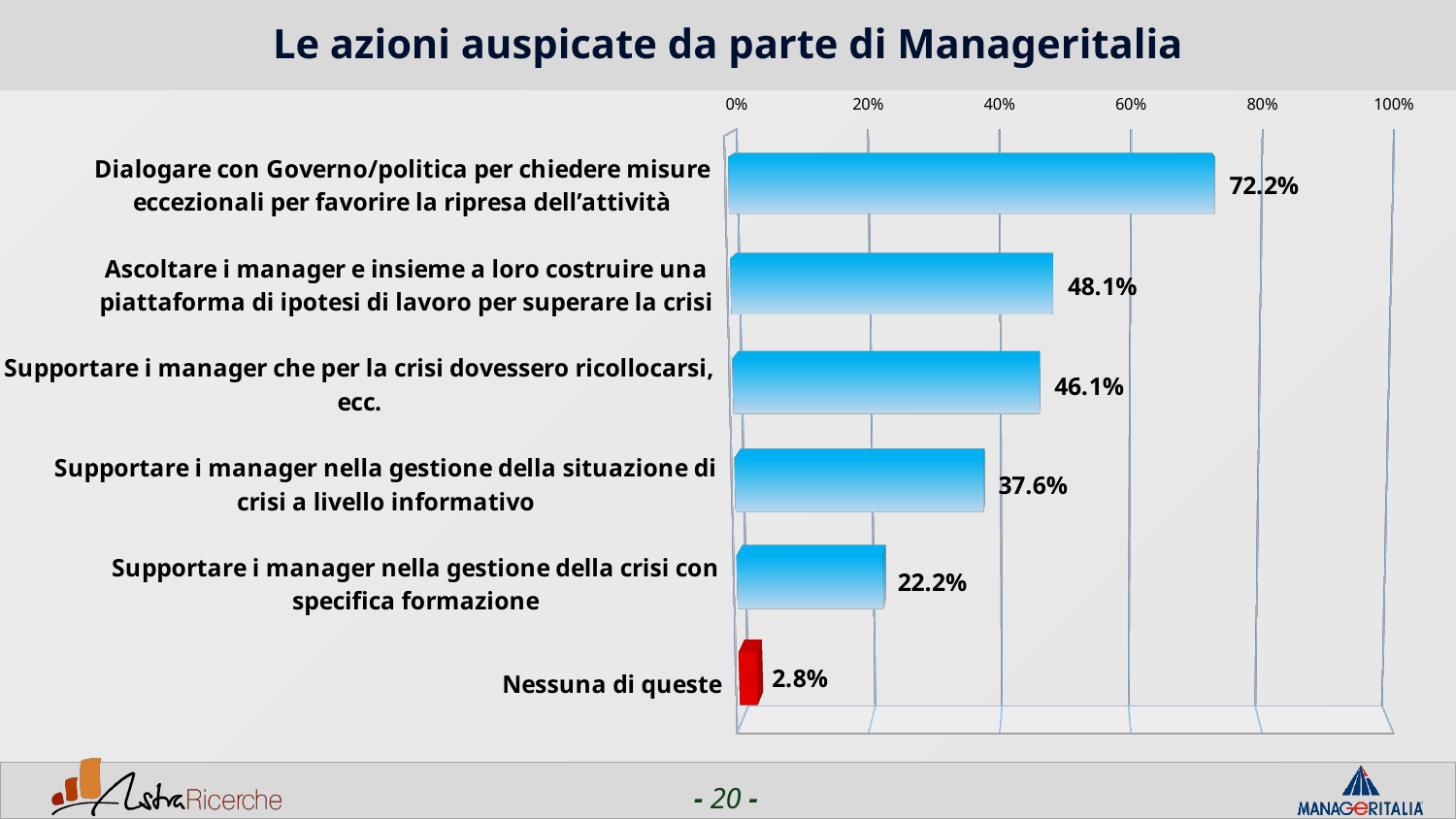
Which category has the highest value? Dialogare con Governo/politica per chiedere misure eccezionali per favorire la ripresa dell'attività What is the title of the slide? Le azioni auspicate da parte di Manageritalia How many categories are shown in the chart? 6 What is the value for "Supportare i manager nella gestione della crisi con specifica formazione"? 22.2% What is the difference between the values for "Supportare i manager nella gestione della situazione di crisi a livello informativo" and "Supportare i manager nella gestione della crisi con specifica formazione"? 15.4% What is the value for "Ascoltare i manager e insieme a loro costruire una piattaforma di ipotesi di lavoro per superare la crisi"? 48.1% Which category has the lowest value? Nessuna di queste Is the value for "Supportare i manager che per la crisi dovessero ricollocarsi, ecc." greater or less than 40%? greater What kind of chart is shown on the slide? bar chart Which is larger: the value for "Supportare i manager che per la crisi dovessero ricollocarsi, ecc." or the value for "Supportare i manager nella gestione della situazione di crisi a livello informativo"? Supportare i manager che per la crisi dovessero ricollocarsi, ecc. What is the difference between the values for "Dialogare con Governo/politica..." (72.2%) and "Ascoltare i manager..." (48.1%)? 24.1% What is the value for "Nessuna di queste"? 2.8%